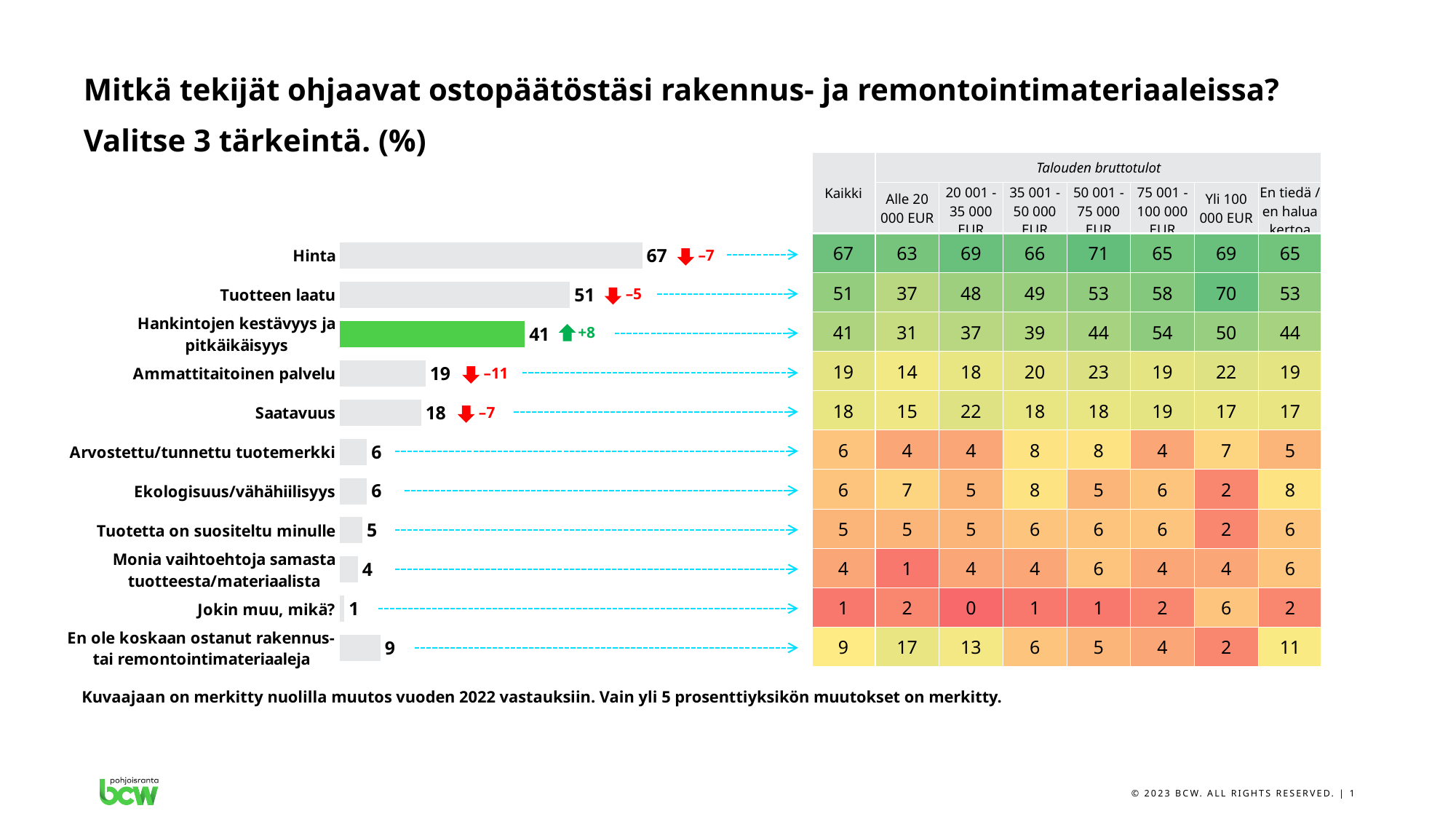
What is the value for Hinta in the bar chart? 67 In the table, what is the value for Tuotteen laatu in the Yli 100 000 EUR column? 70 How many categories are shown in the bar chart? 11 Which is larger in the bar chart, Ammattitaitoinen palvelu or Saatavuus? Ammattitaitoinen palvelu Which category has the lowest value in the bar chart? Jokin muu, mikä? Which category has the highest value in the bar chart? Hinta Which category in the bar chart is marked with a green upward arrow? Hankintojen kestävyys ja pitkäikäisyys What kind of chart is shown on the left of the slide? bar chart What is the difference between the values for Hinta and Tuotteen laatu in the bar chart? 16 What change versus 2022 is marked next to Ammattitaitoinen palvelu in the bar chart? -11 What is the value for Hankintojen kestävyys ja pitkäikäisyys in the bar chart? 41 In the table, what is the value for Hinta in the 50 001 - 75 000 EUR column? 71